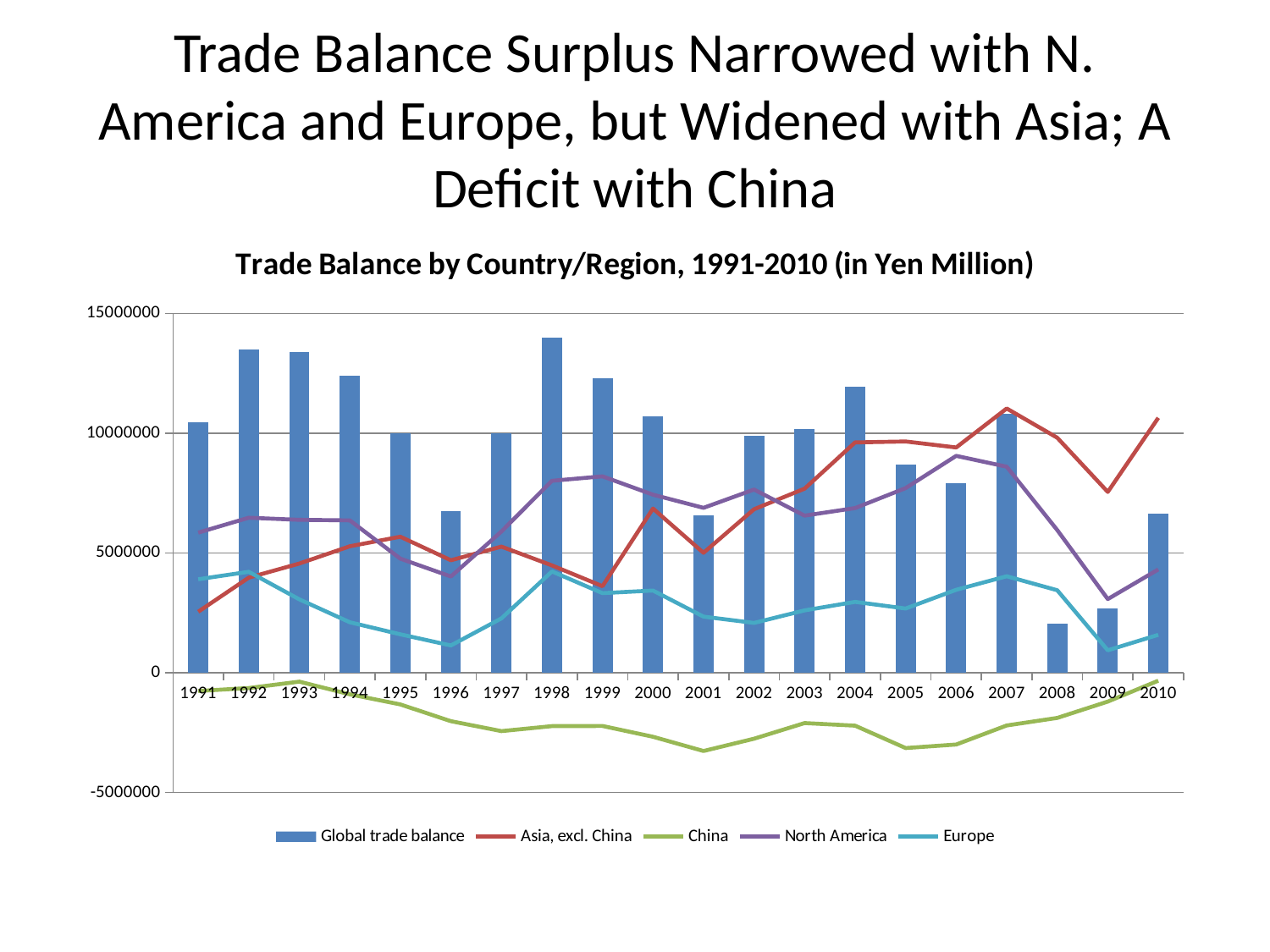
How many series does the chart's legend list? 5 Is the Global trade balance value for 1998 greater or less than 10000000? greater What kind of chart is shown on the slide? combination bar and line chart In 2010, which is larger: the value for Asia, excl. China or the value for Europe? Asia, excl. China In which year is the Global trade balance bar the shortest? 2008 In which year is the Global trade balance bar the tallest? 1998 Does the Europe line rise or fall from 1991 to 1996? fall Which series is plotted as bars in the chart? Global trade balance Is the China value for 2001 greater or less than 0? less Is the Global trade balance value for 2008 greater or less than 5000000? less What is the title of the chart? Trade Balance by Country/Region, 1991-2010 (in Yen Million) How many years are shown on the x axis of the chart? 20